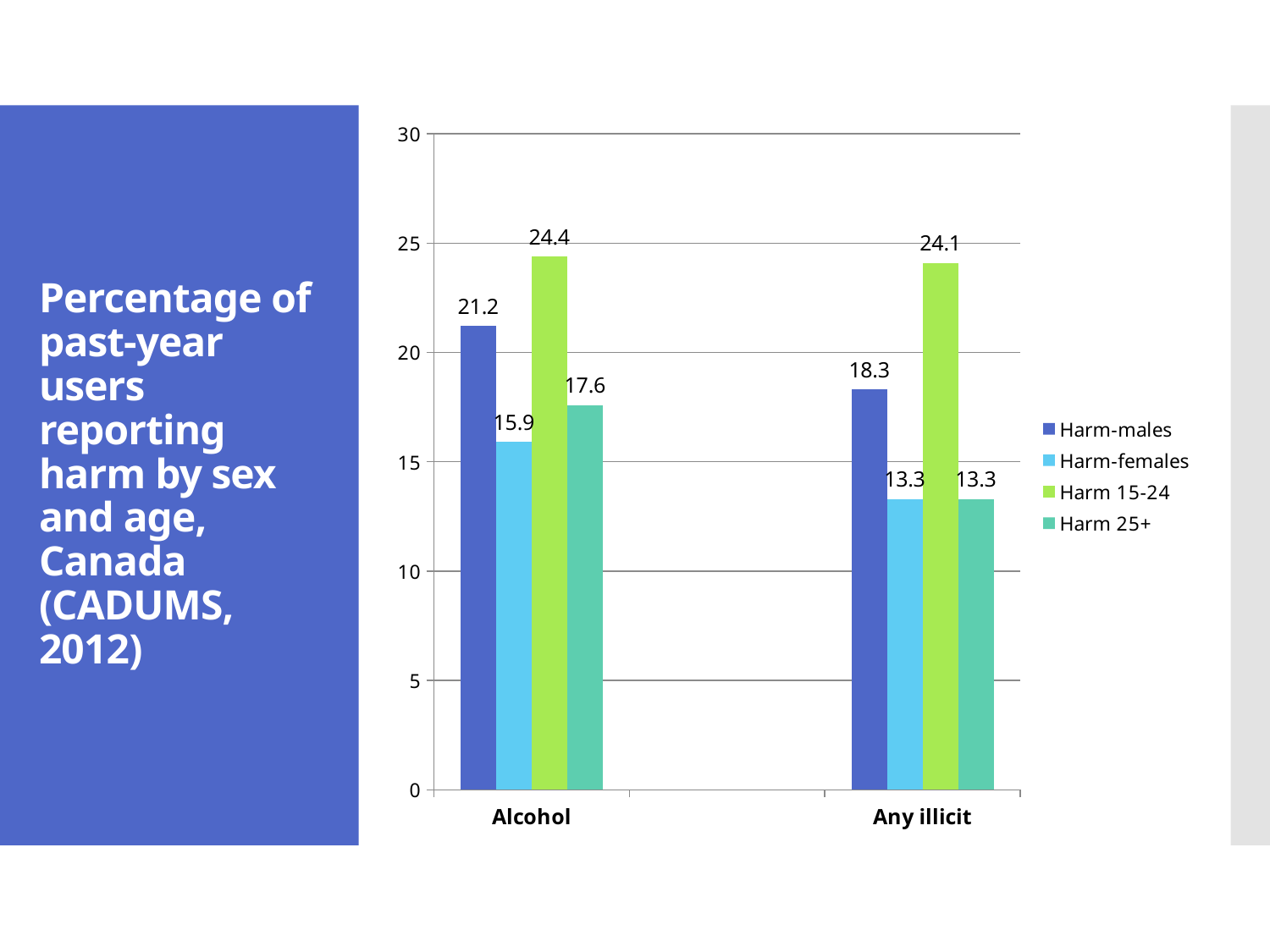
What is the difference between the Harm-males values for Alcohol and Any illicit? 2.9 What kind of chart is shown on the slide? Bar chart What is the value for Harm-females in the Any illicit category? 13.3 What is the value for Harm 15-24 in the Alcohol category? 24.4 How many series does the legend list? 4 Is the value for Harm-females in the Alcohol category greater or less than 20? less What is the value for Harm-males in the Alcohol category? 21.2 Which series has the highest value in the Any illicit category? Harm 15-24 Which series has the lowest value in the Alcohol category? Harm-females Which is larger: Harm 25+ for Alcohol or Harm 25+ for Any illicit? Harm 25+ for Alcohol What is the value for Harm 25+ in the Alcohol category? 17.6 How many categories are shown on the x axis? 2